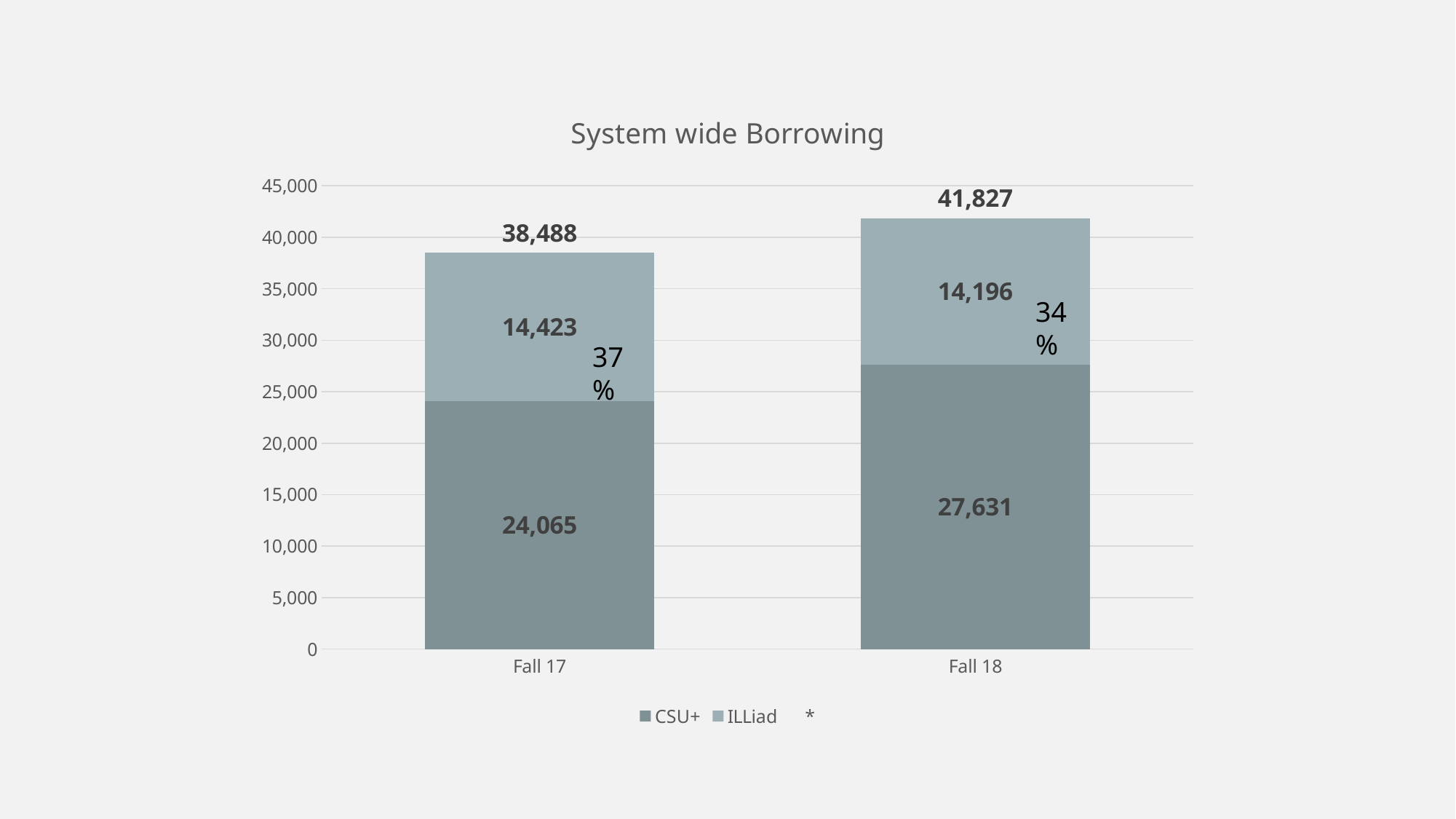
What is the ILLiad value for Fall 17? 14,423 What is the total of the stacked bar for Fall 17? 38,488 What is the CSU+ value for Fall 17? 24,065 What is the difference between the CSU+ values for Fall 18 and Fall 17? 3,566 What is the ILLiad value for Fall 18? 14,196 What is the CSU+ value for Fall 18? 27,631 What is the total of the stacked bar for Fall 18? 41,827 How many categories are shown on the x axis? 2 What is the title of the chart? System wide Borrowing Which category has the higher total, Fall 17 or Fall 18? Fall 18 What kind of chart is shown? Stacked bar chart What is the difference between the totals for Fall 18 and Fall 17? 3,339